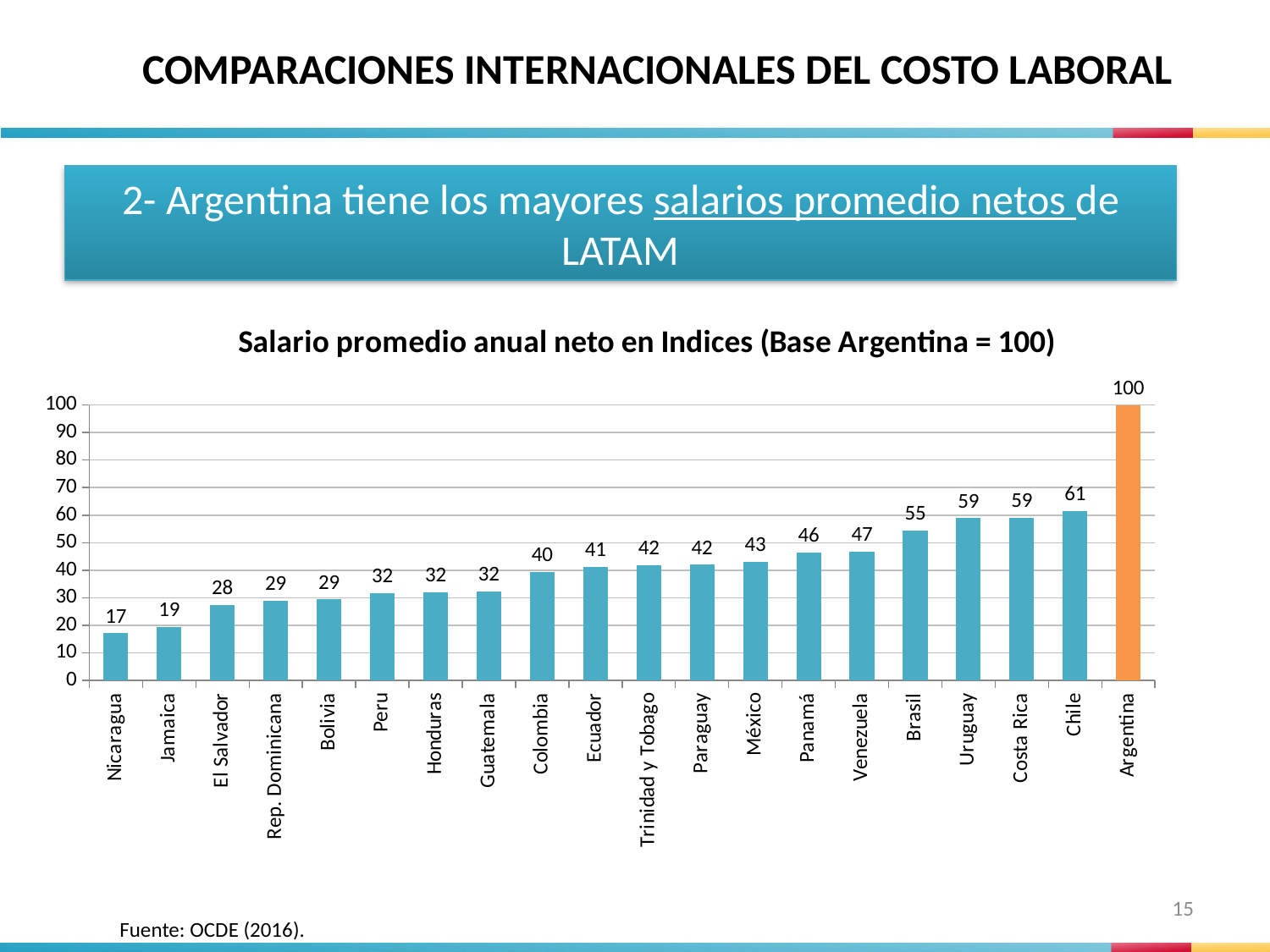
Which is larger, the value for Panamá or the value for Colombia? Panamá What is the value for Chile? 61 Do the values rise or fall from left to right along the x axis? Rise Which country has the lowest value? Nicaragua What kind of chart is shown on the slide? Bar chart How many countries are shown in the chart? 20 Which country has the highest value? Argentina What is the value for Nicaragua? 17 What is the value for Brasil? 55 What is the difference between the values for Argentina and Chile? 39 What is the title of the chart? Salario promedio anual neto en Indices (Base Argentina = 100) What is the difference between the values for Uruguay and Jamaica? 40